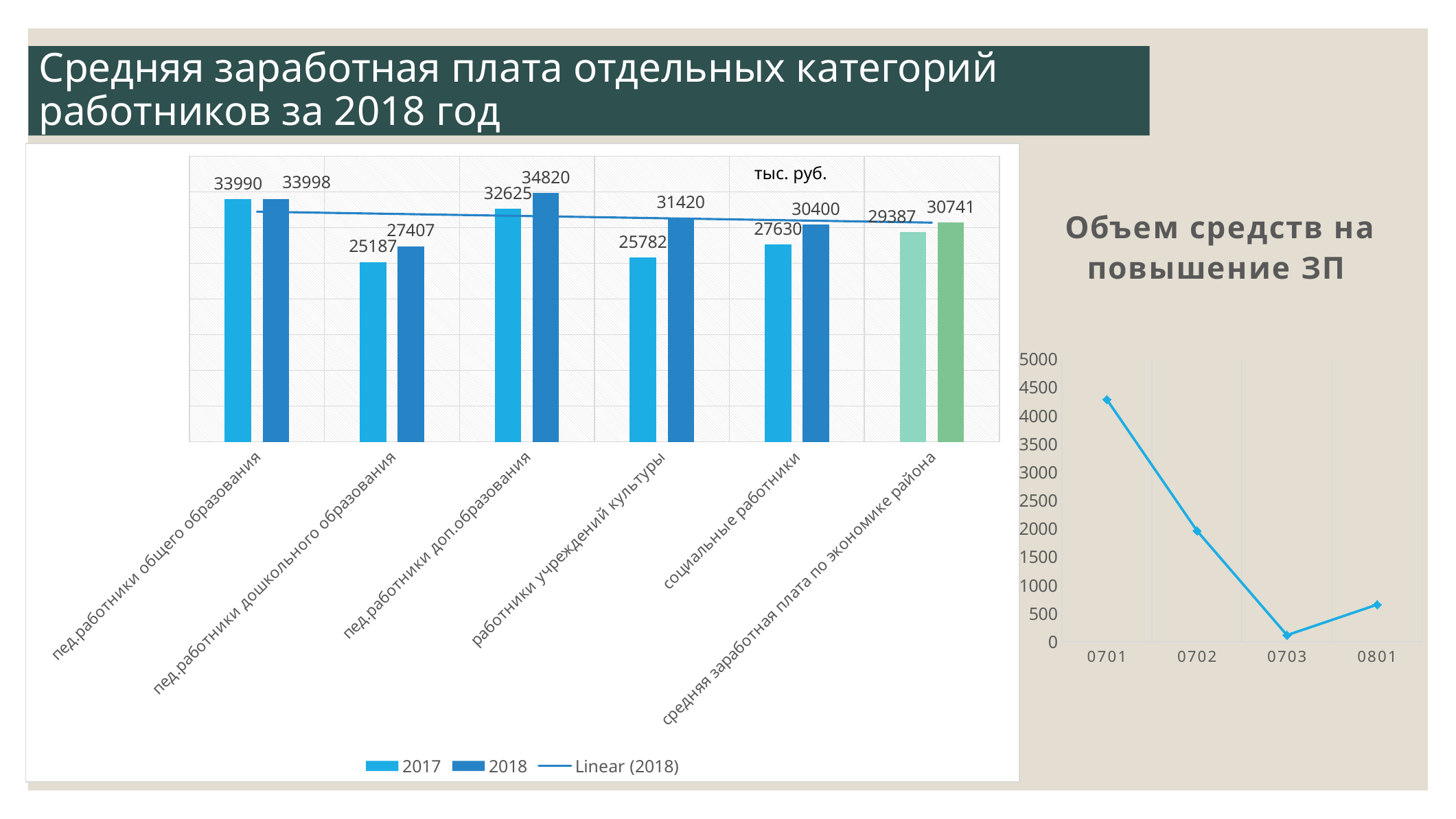
How many entries does the legend of the left bar chart list? 3 In the left bar chart, what is the 2018 value for социальные работники? 30400 In the left bar chart, what is the difference between the 2018 and 2017 values for работники учреждений культуры? 5638 How many categories are shown on the x axis of the left bar chart? 6 In the left bar chart, what is the 2017 value for работники учреждений культуры? 25782 In the chart 'Объем средств на повышение ЗП', is the value for 0701 greater or less than 4000? greater In the left bar chart, which category has the lowest 2017 value? пед.работники дошкольного образования In the left bar chart, which category has the highest 2018 value? пед.работники доп.образования What kind of chart is the chart titled 'Объем средств на повышение ЗП'? line chart In the left bar chart, which is larger for пед.работники дошкольного образования: the 2017 value or the 2018 value? 2018 In the chart 'Объем средств на повышение ЗП', which category has the lowest value? 0703 In the left bar chart, what is the 2018 value for пед.работники доп.образования? 34820